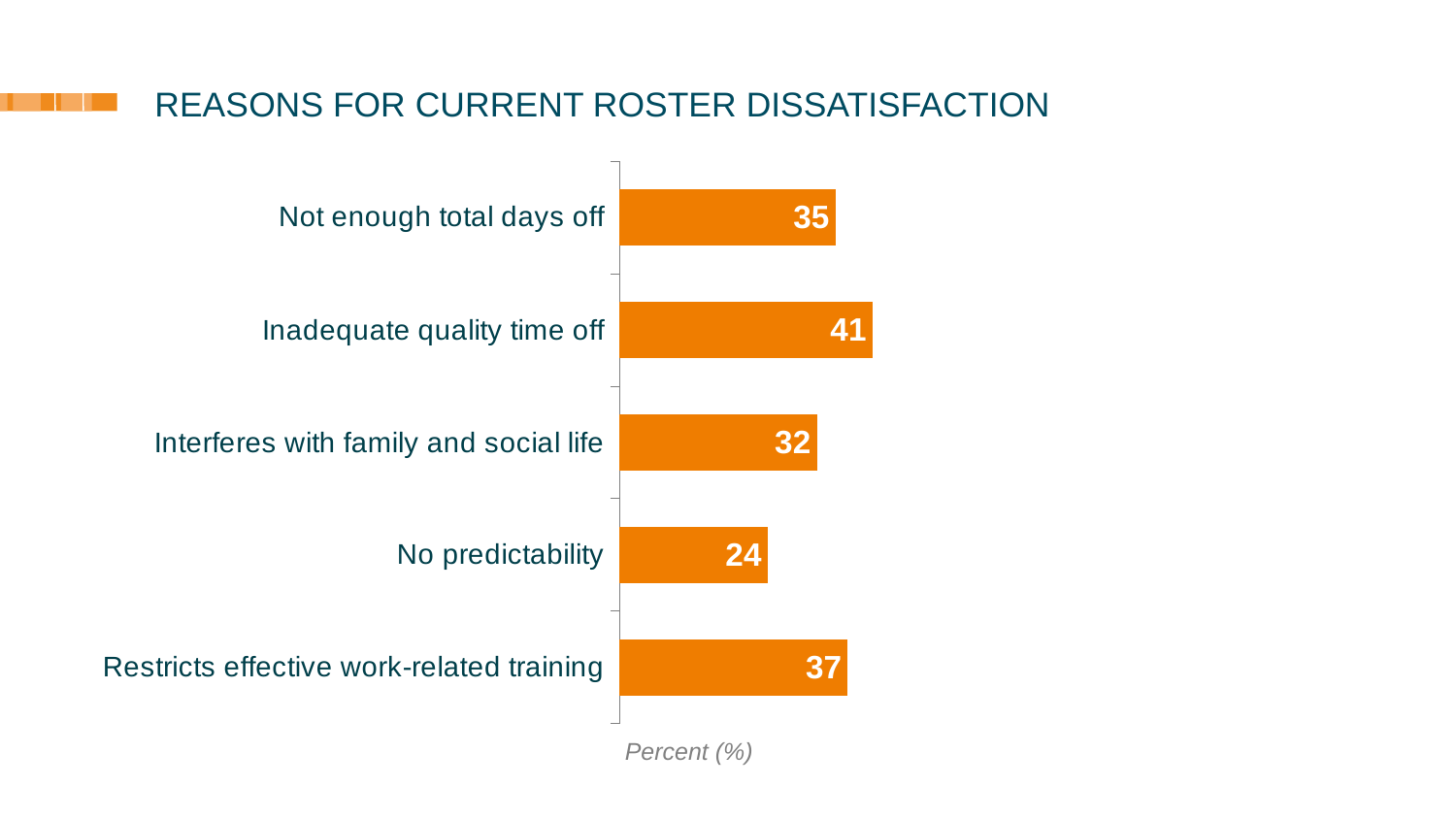
What kind of chart is shown on the slide? Bar chart Which is larger, the value for "Not enough total days off" or "Restricts effective work-related training"? Restricts effective work-related training Which reason has the lowest value? No predictability What is the value for "Inadequate quality time off"? 41 How many reasons are shown in the chart? 5 What is the value for "Restricts effective work-related training"? 37 What is the value for "Interferes with family and social life"? 32 Which reason has the highest value? Inadequate quality time off What is the difference between the values for "Inadequate quality time off" and "No predictability"? 17 What is the value for "Not enough total days off"? 35 What is the axis label shown below the bars? Percent (%) What is the value for "No predictability"? 24